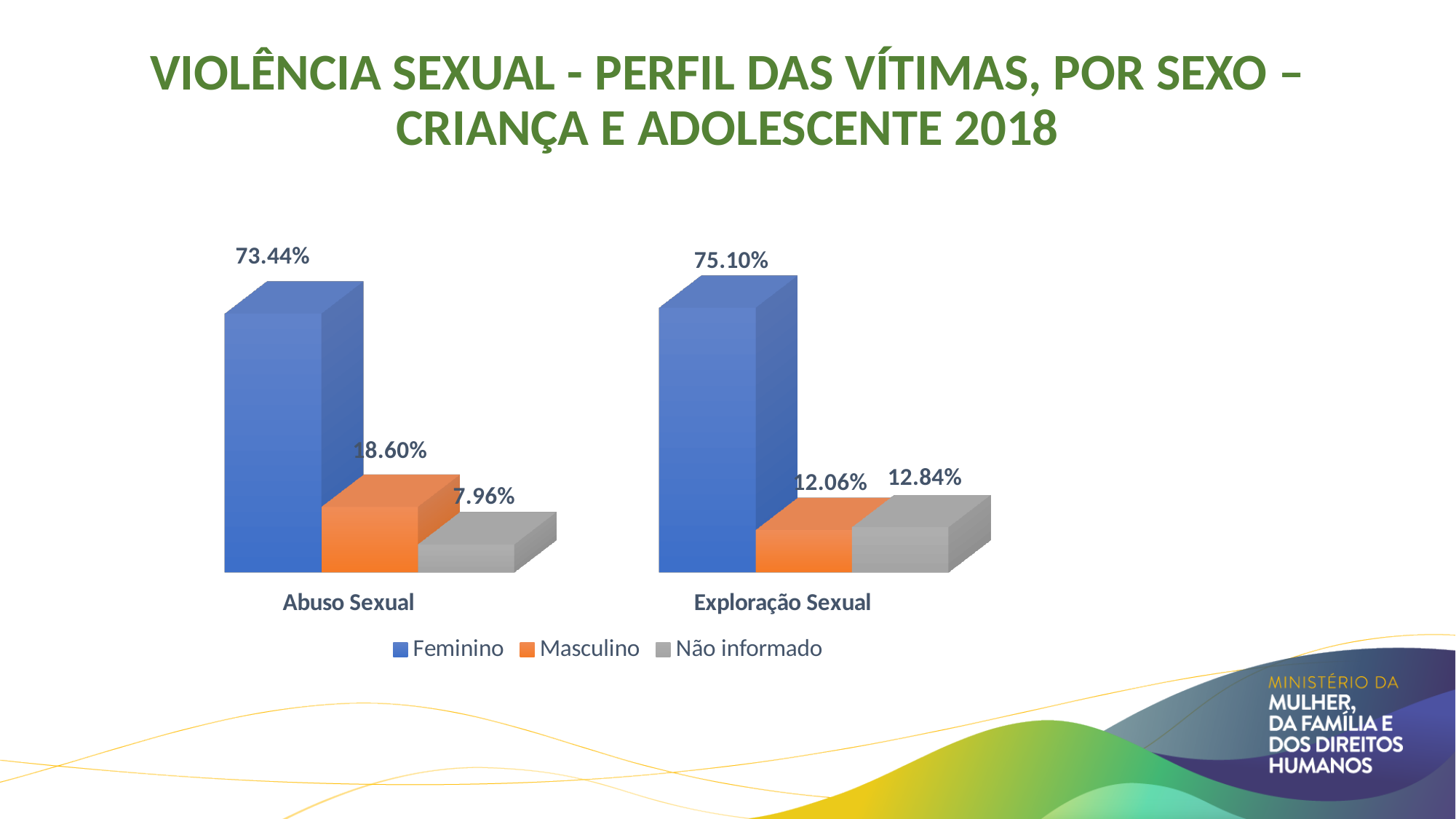
What is the value for Feminino in the Abuso Sexual category? 73.44% Which colour represents the Masculino series? Orange How many series does the legend list? 3 Which series has the lowest value in the Abuso Sexual category? Não informado Which series has the highest value in the Exploração Sexual category? Feminino What kind of chart is shown on the slide? Bar chart What is the value for Não informado in the Abuso Sexual category? 7.96% What is the value for Feminino in the Exploração Sexual category? 75.10% Which is larger: the Feminino value for Abuso Sexual or the Feminino value for Exploração Sexual? Exploração Sexual How many categories are shown on the x axis? 2 What is the difference between the Masculino and Não informado values in the Abuso Sexual category? 10.64% What is the value for Masculino in the Exploração Sexual category? 12.06%